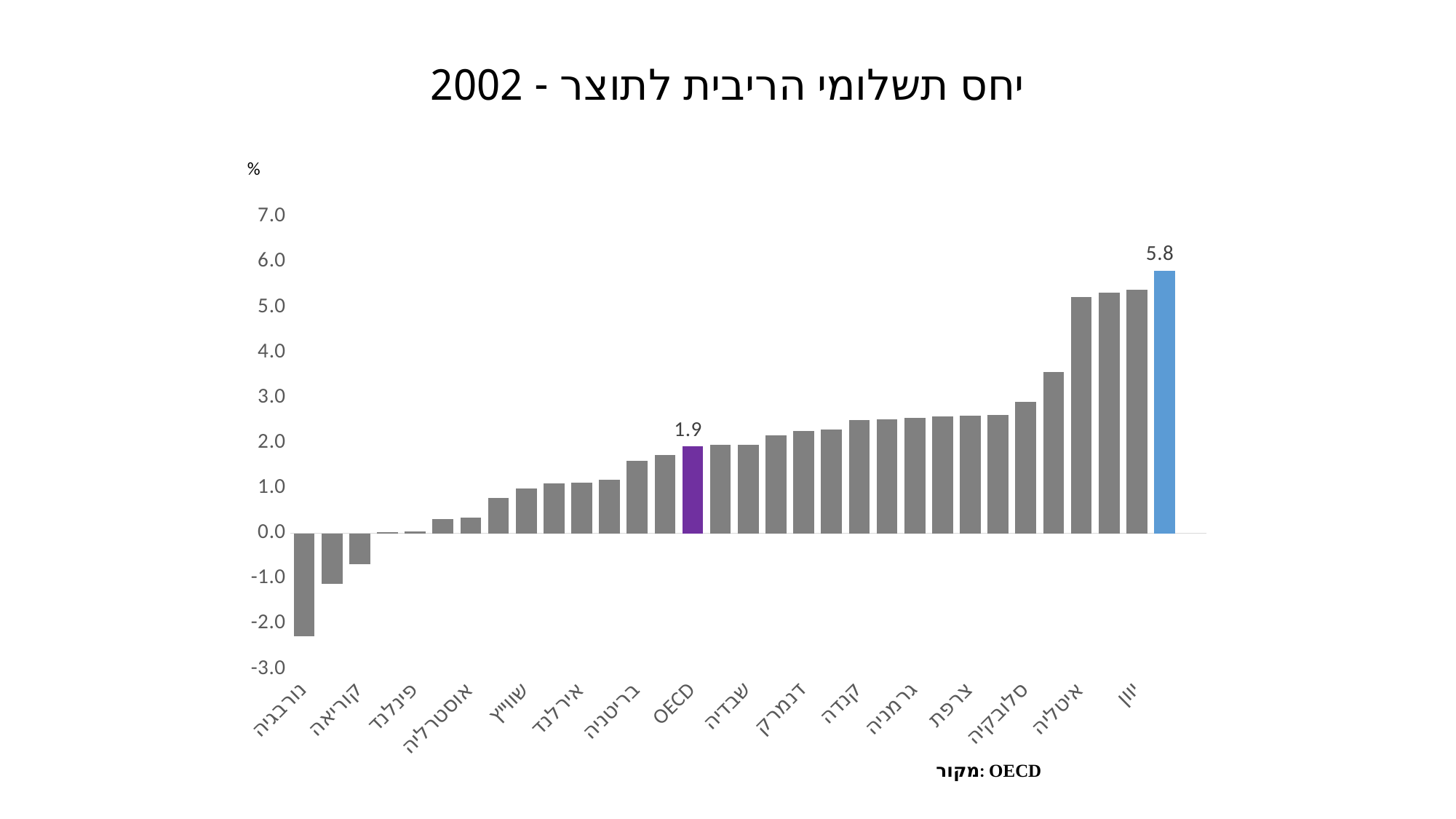
What is the value for OECD? 1.9 What colour is the bar for יוון? gray What kind of chart is shown on the slide? bar chart Do the values generally rise or fall from left to right along the x axis? rise Which category has the lowest value? נורבגיה What is the title of the chart? יחס תשלומי הריבית לתוצר - 2002 Is the value for יוון greater or less than 5.0? greater Which is larger, the value for יוון or the value for OECD? יוון Is the value for נורבגיה greater or less than -2.0? less